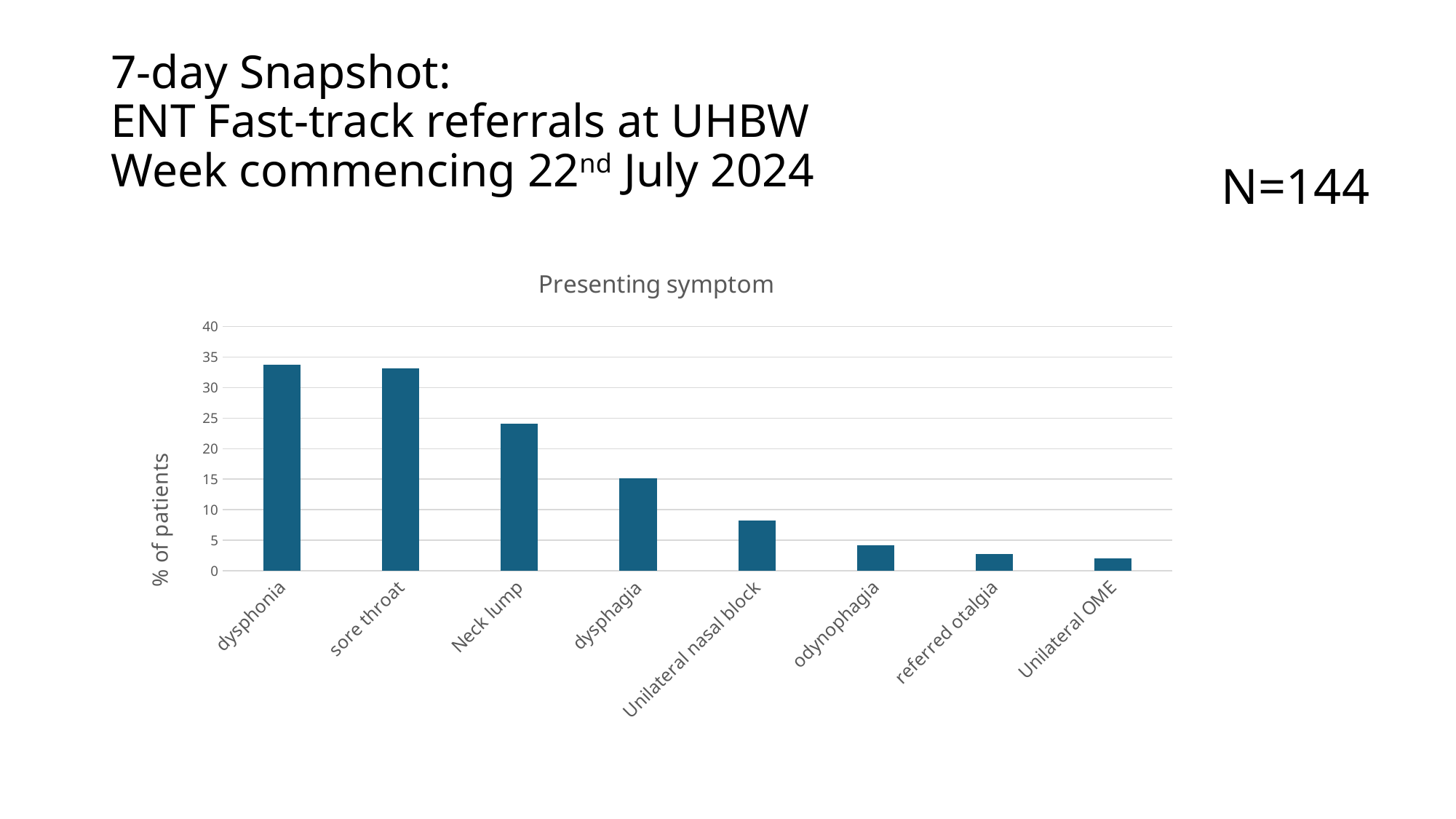
Do the bar values rise or fall moving from left to right across the categories? fall Is the value for dysphonia greater or less than 30? greater Which has the larger value, sore throat or Unilateral nasal block? sore throat Is the value for odynophagia greater or less than 5? less Which has the larger value, Neck lump or dysphagia? Neck lump How many presenting symptom categories are plotted in the chart? 8 What is the title of the chart? Presenting symptom Is the value for Neck lump greater or less than 20? greater What kind of chart is shown on the slide? bar chart What is the label on the vertical axis of the chart? % of patients